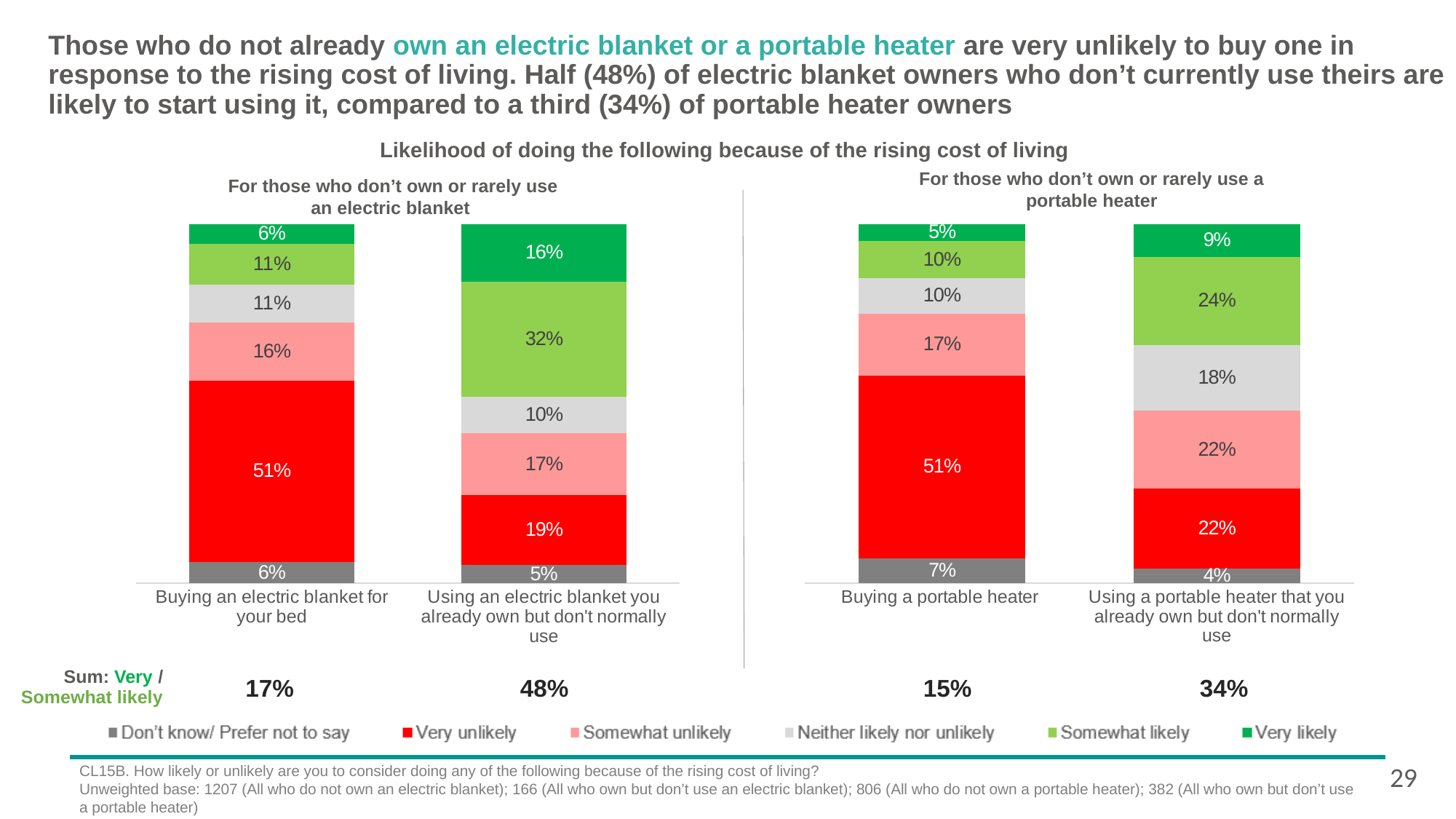
In the electric blanket chart, what percentage are 'Very unlikely' to buy an electric blanket for their bed? 51% In the portable heater chart, what is the combined 'Very' and 'Somewhat likely' share for buying a portable heater? 15% In the electric blanket chart, what is the sum of 'Very' and 'Somewhat likely' for using an electric blanket you already own but don't normally use? 48% In the portable heater chart, which segment is smallest in the 'Using a portable heater that you already own but don't normally use' bar? Don't know/ Prefer not to say In the portable heater chart, what is the difference between the 'Very unlikely' shares for buying a portable heater and using a portable heater you already own? 29% In the electric blanket chart, which segment is largest in the 'Buying an electric blanket for your bed' bar? Very unlikely In the portable heater chart, what percentage are 'Very likely' to use a portable heater they already own but don't normally use? 9% In the portable heater chart, what percentage answered 'Don't know/ Prefer not to say' for buying a portable heater? 7% How many series does the legend list? 6 In the electric blanket chart, what percentage are 'Somewhat likely' to use an electric blanket they already own but don't normally use? 32% In the electric blanket chart, is the 'Very likely' share larger for buying an electric blanket or for using one you already own? Using an electric blanket you already own but don't normally use What type of chart is used on this slide? Stacked bar chart